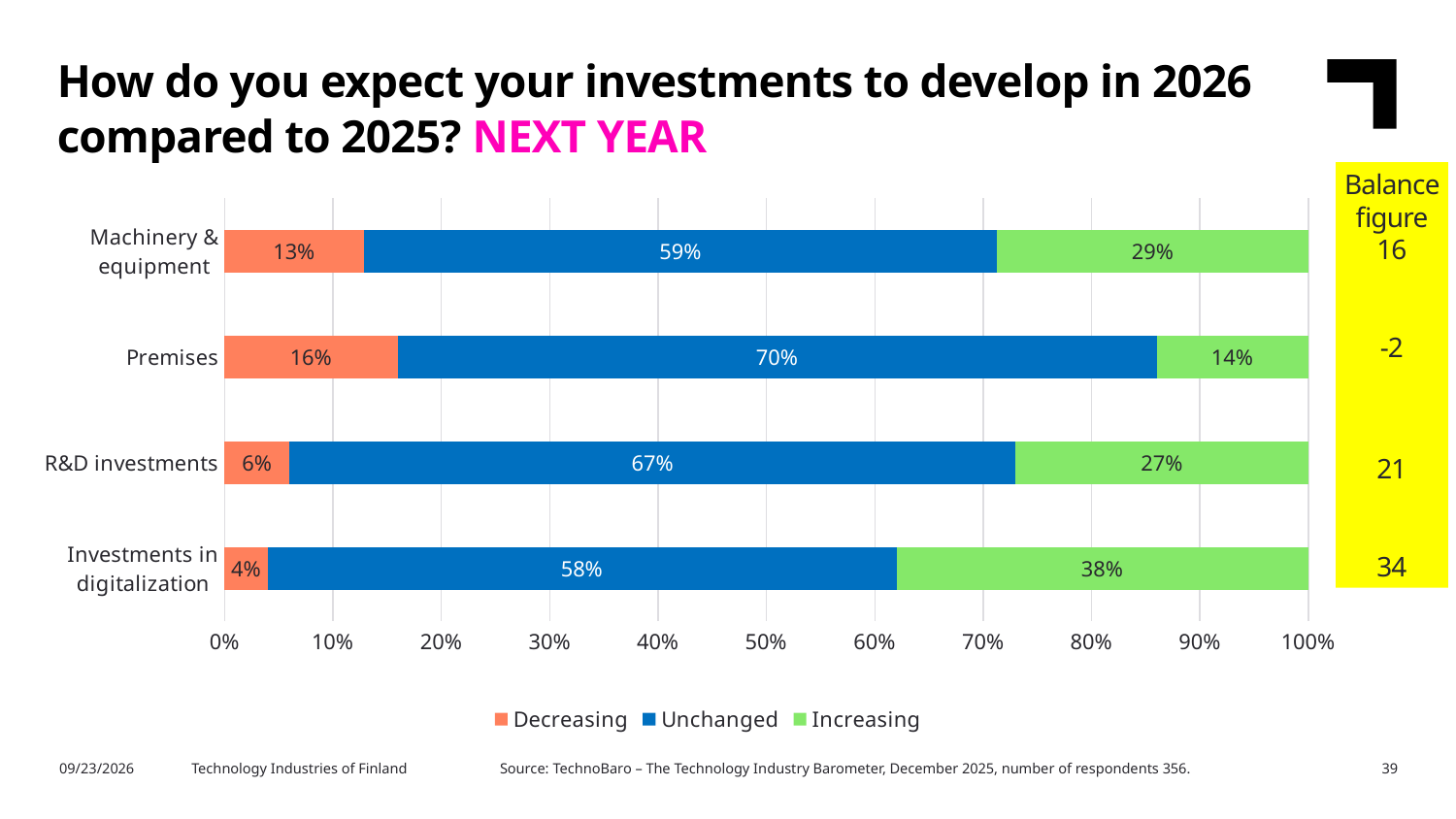
What is the Increasing value for Investments in digitalization? 38% What kind of chart is shown on the slide? Stacked horizontal bar chart What is the difference between the Unchanged values for Premises and Investments in digitalization? 12 percentage points Which is larger: the Increasing value for Machinery & equipment or for R&D investments? Machinery & equipment What is the Decreasing value for Premises? 16% Which category has the lowest Decreasing share? Investments in digitalization How many categories are shown on the chart? 4 What is the balance figure shown for R&D investments? 21 How many series does the legend list? 3 Which category has the highest Increasing share? Investments in digitalization Which colour represents the Increasing series in the legend? Green What percentage of respondents expect Machinery & equipment investments to be Unchanged? 59%